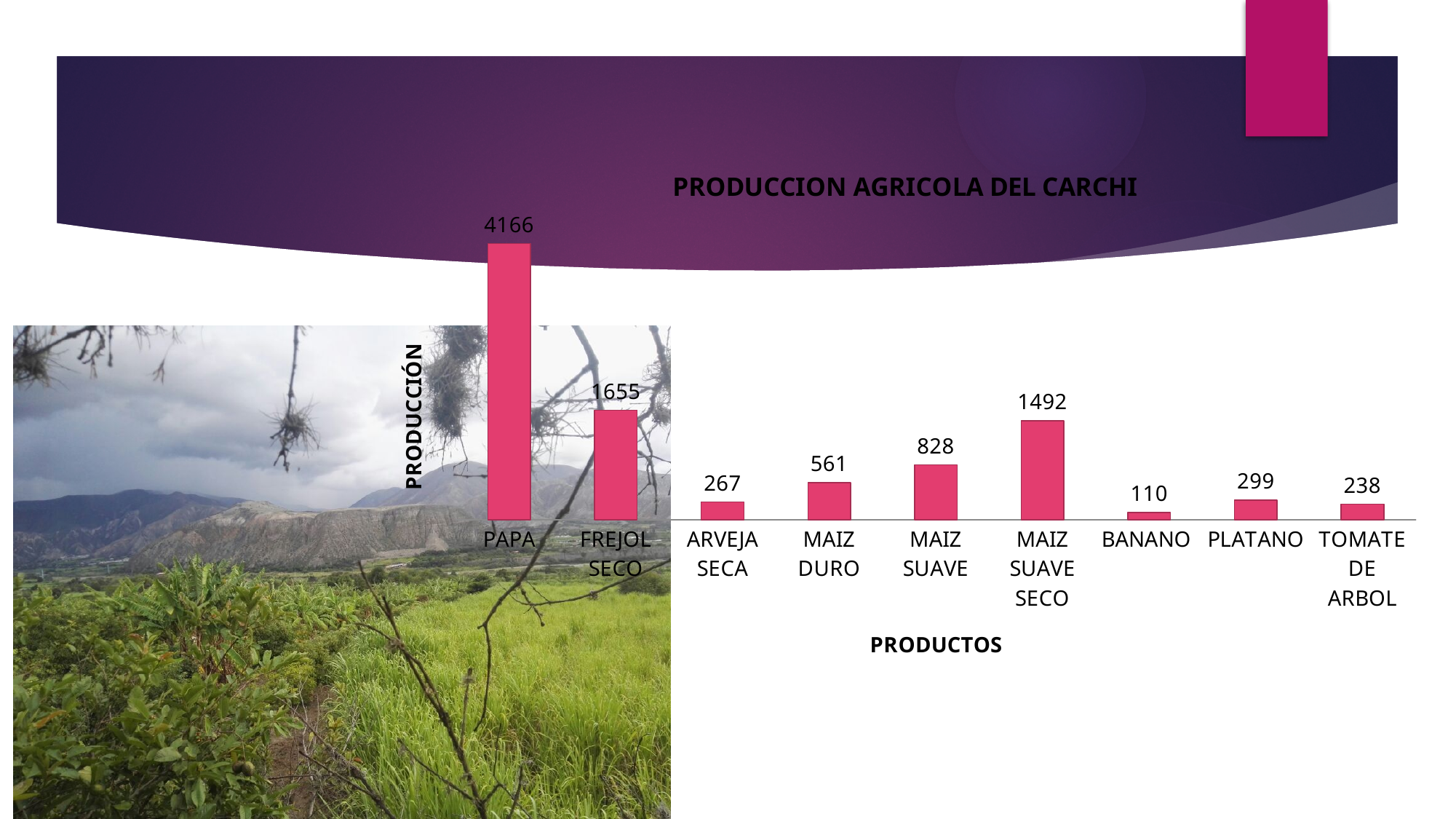
What is the production value for PAPA? 4166 What is the difference between the production of PAPA and FREJOL SECO? 2511 What type of chart is shown on the slide? Bar chart How many products are shown in the chart? 9 What is the difference between the production of MAIZ SUAVE and MAIZ DURO? 267 What is the production value for TOMATE DE ARBOL? 238 What is the production value for BANANO? 110 Which product has the lowest production? BANANO What is the title of the chart? PRODUCCION AGRICOLA DEL CARCHI Which has a larger production, PLATANO or ARVEJA SECA? PLATANO Which product has the highest production? PAPA What is the production value for MAIZ SUAVE SECO? 1492